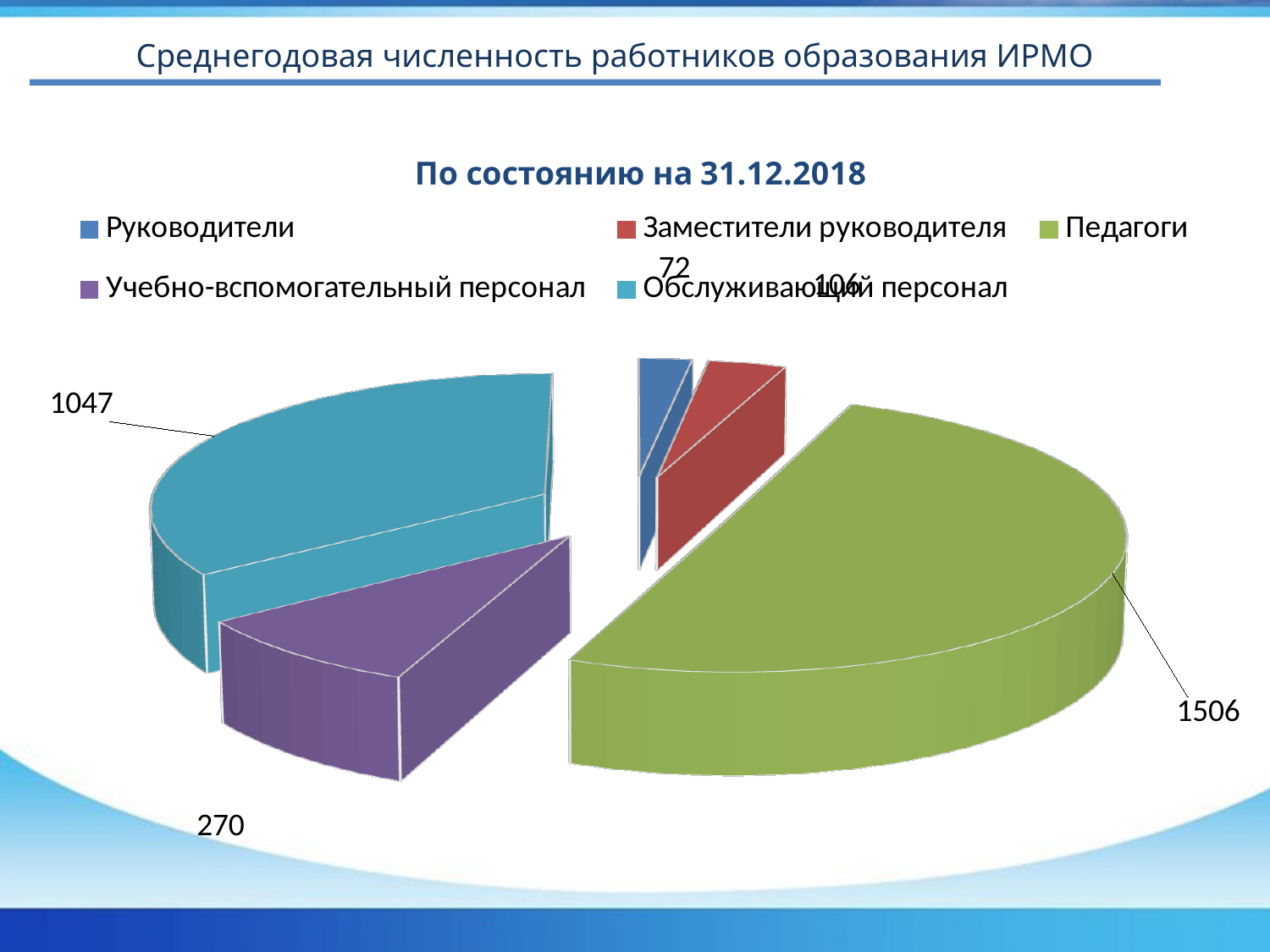
Which is larger, Обслуживающий персонал or Учебно-вспомогательный персонал? Обслуживающий персонал What kind of chart is shown on the slide? pie chart Which category has the smallest slice of the pie? Руководители What is the value for Учебно-вспомогательный персонал? 270 What is the title of the chart? По состоянию на 31.12.2018 What is the difference between the values for Обслуживающий персонал and Учебно-вспомогательный персонал? 777 What is the value for Руководители? 72 What is the difference between the values for Педагоги and Обслуживающий персонал? 459 What is the value for Педагоги? 1506 What is the value for Обслуживающий персонал? 1047 How many categories does the legend list? 5 Which category has the largest slice of the pie? Педагоги